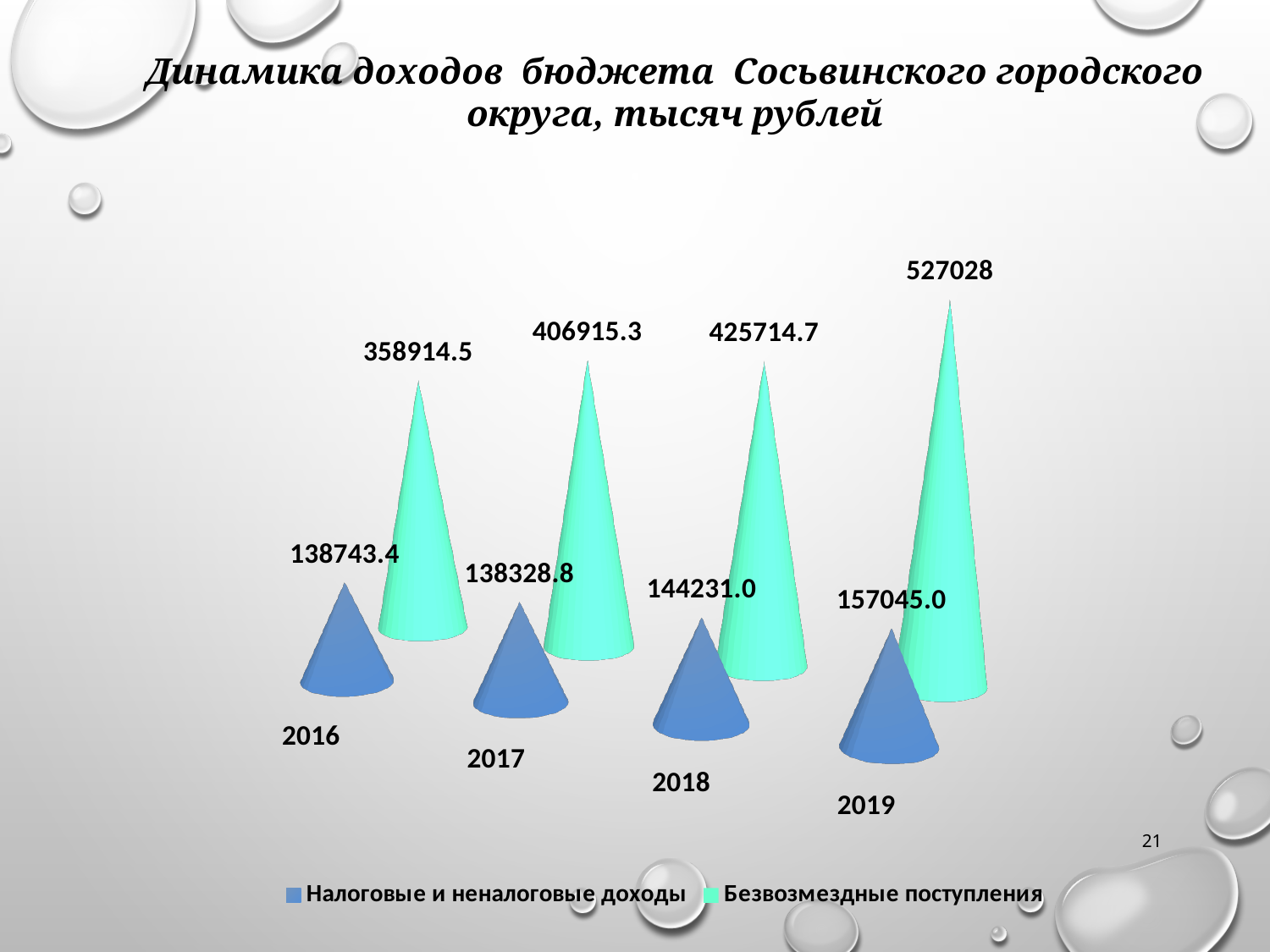
Which is larger: Налоговые и неналоговые доходы in 2019 or in 2018? 2019 Do the values of Безвозмездные поступления rise or fall from 2016 to 2019? Rise In which year is Безвозмездные поступления highest? 2019 What is the value of Налоговые и неналоговые доходы for 2016? 138743.4 What is the value of Безвозмездные поступления for 2017? 406915.3 What kind of chart is shown on the slide? Bar chart In which year is Безвозмездные поступления lowest? 2016 How many years are shown on the x axis? 4 How many series does the legend list? 2 What is the value of Налоговые и неналоговые доходы for 2018? 144231.0 What is the difference between Безвозмездные поступления in 2019 and 2018? 101313.3 What is the value of Безвозмездные поступления for 2019? 527028